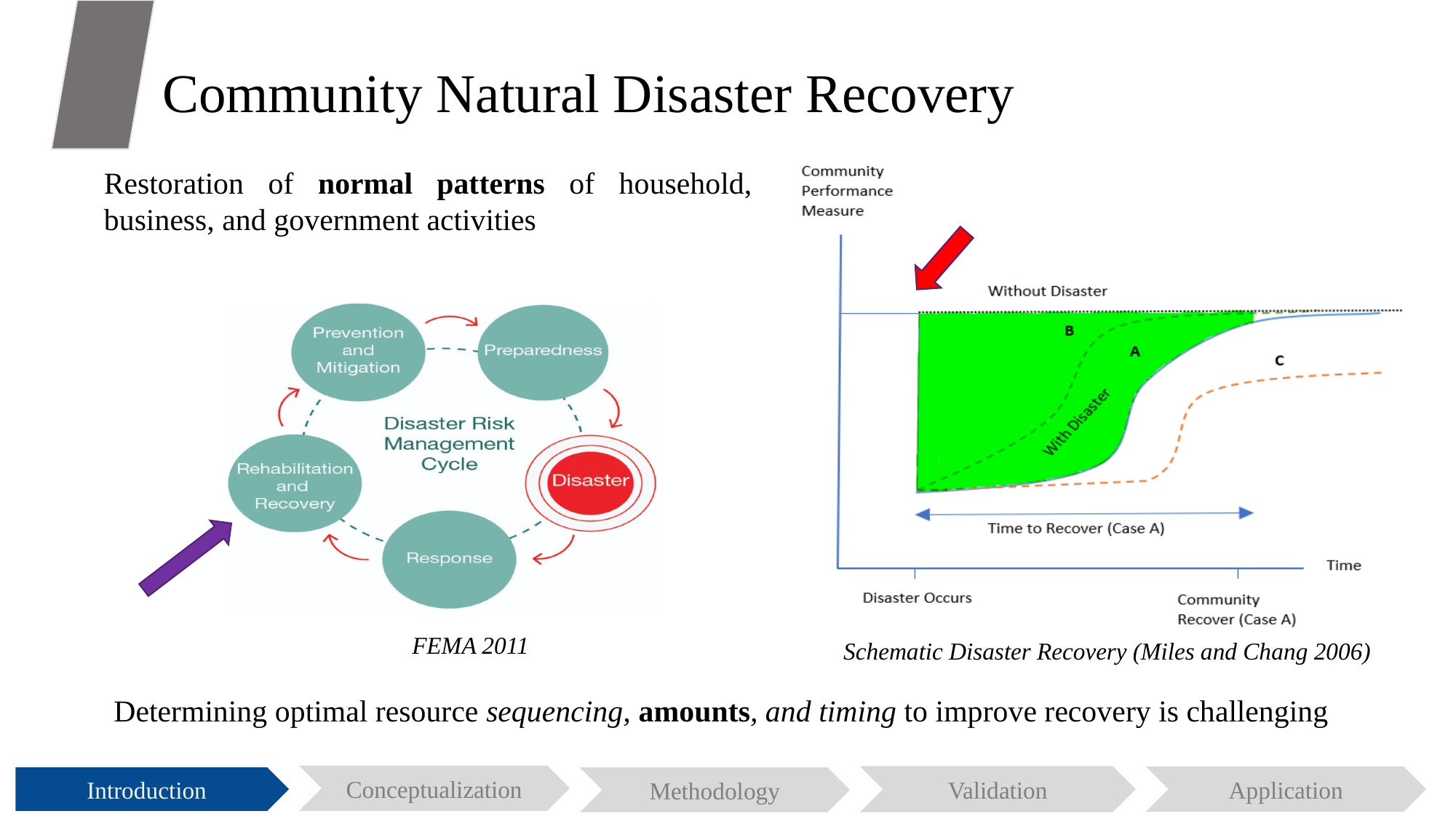
In the Schematic Disaster Recovery chart, how many recovery cases are labeled with letters? 3 In the Schematic Disaster Recovery chart, which case returns to the Without Disaster level earliest? B In the Schematic Disaster Recovery chart, which case takes the longest to recover? C In the Disaster Risk Management Cycle diagram, how many circles are shown in the cycle? 5 In the Disaster Risk Management Cycle diagram, which stage comes directly after Disaster? Response In the Schematic Disaster Recovery chart, what does the horizontal dotted line at the top represent? Without Disaster In the Schematic Disaster Recovery chart, which recovers sooner, Case A or Case C? Case A In the Disaster Risk Management Cycle diagram, which stage does the purple arrow point to? Rehabilitation and Recovery In the Schematic Disaster Recovery chart, what kind of chart is shown? line chart In the Schematic Disaster Recovery chart, does the With Disaster curve rise or fall over time after the disaster occurs? rise In the Schematic Disaster Recovery chart, what is the label on the vertical axis? Community Performance Measure